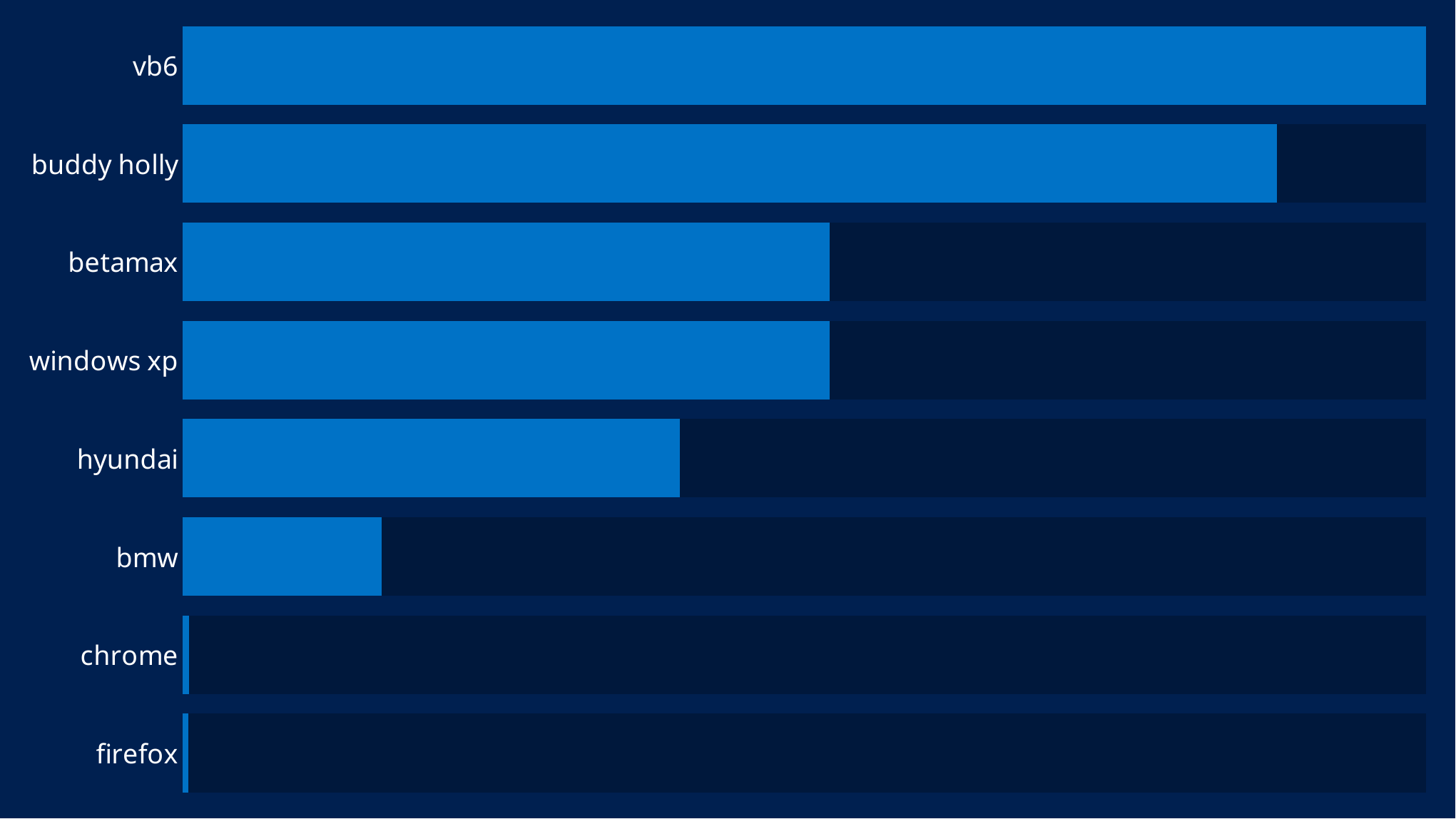
Do the bar lengths increase or decrease going from the top category to the bottom category? decrease Which category is listed at the bottom of the chart? firefox Which bar is longer, vb6 or buddy holly? vb6 Which bar is longer, bmw or chrome? bmw What kind of chart is shown on the slide? bar chart Which bar is longer, buddy holly or hyundai? buddy holly Which category is listed at the top of the chart? vb6 How many categories are plotted in the bar chart? 8 Which category has the longest bar? vb6